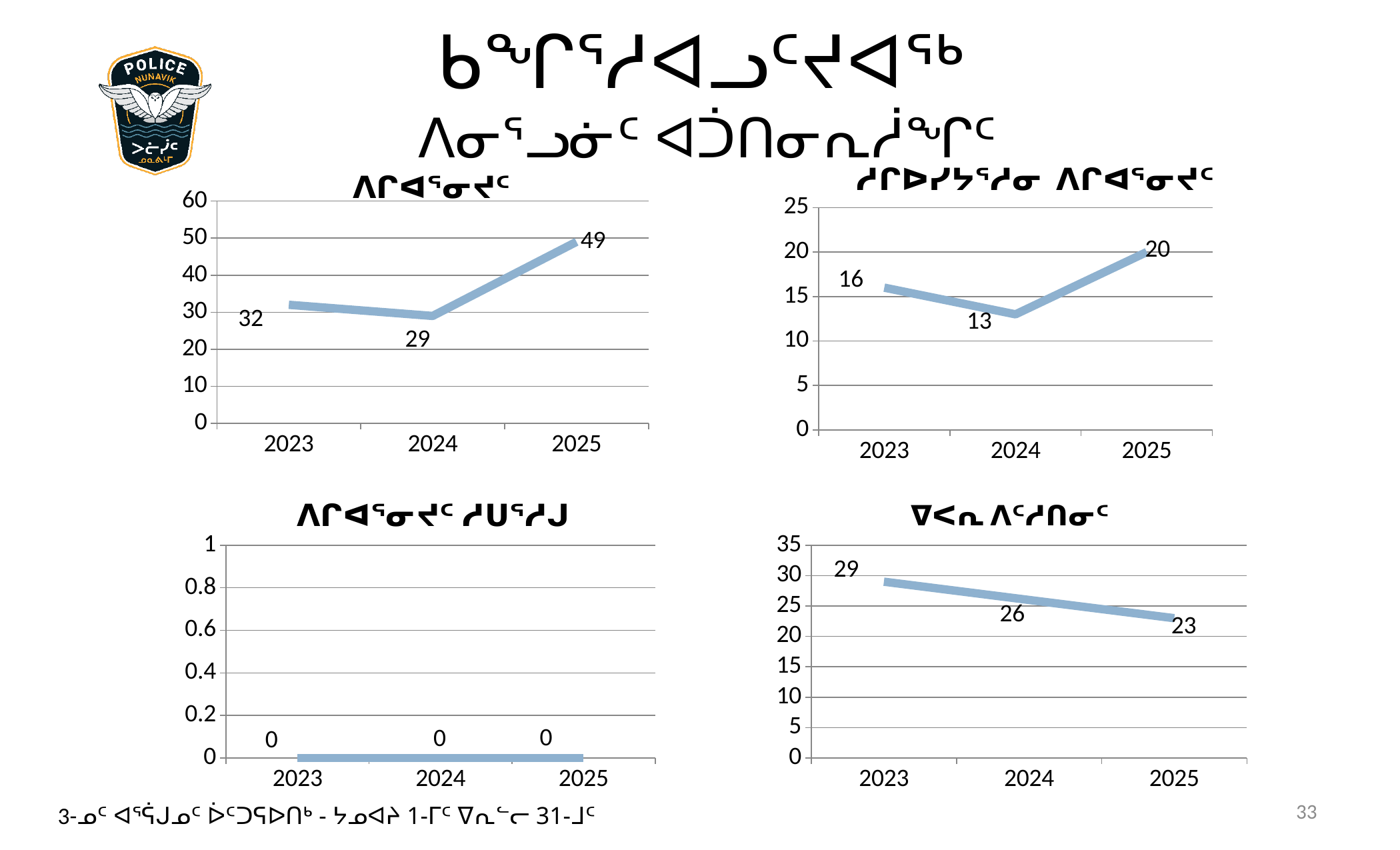
In the top-right chart, what is the value for 2023? 16 In the bottom-right chart, what is the difference between the 2023 and 2025 values? 6 In the bottom-right chart, do the values rise or fall from 2023 to 2025? fall How many years are shown on the x axis of the top-right chart? 3 In the bottom-right chart, what is the value for 2025? 23 What type of chart is the bottom-right chart? line chart In the top-right chart, which year has the highest value? 2025 In the top-left chart, what is the difference between the 2025 and 2024 values? 20 In the top-right chart, is the value for 2024 larger or smaller than the value for 2023? smaller In the bottom-left chart, what is the value for 2024? 0 In the top-left chart, which year has the lowest value? 2024 In the top-left chart, what is the value for 2025? 49